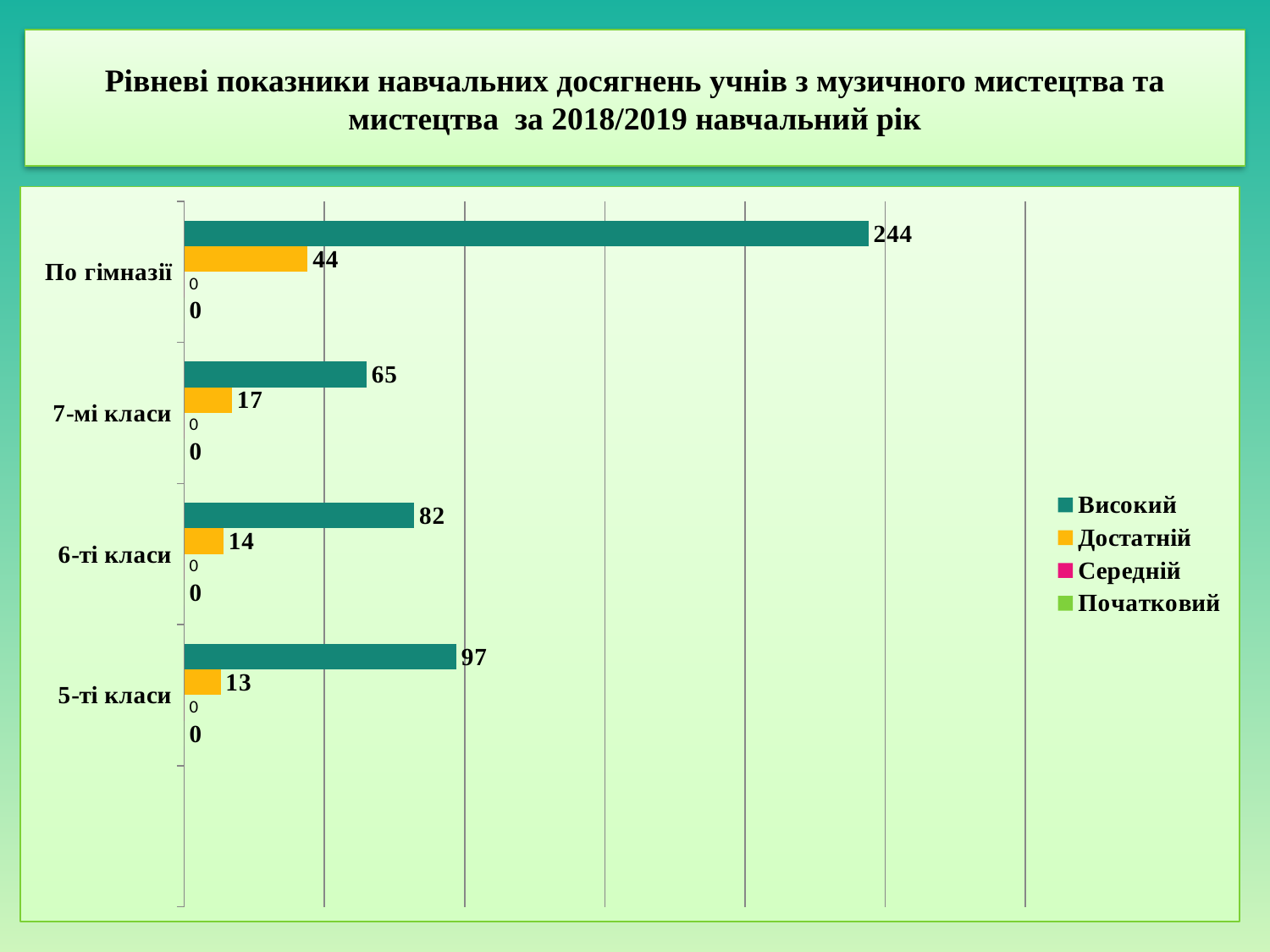
Which category has the lowest Достатній value? 5-ті класи What is the value of Середній for 5-ті класи? 0 Which is larger: the Достатній value for 7-мі класи or for 6-ті класи? 7-мі класи What is the value of Високий for По гімназії? 244 What is the difference between the Високий values for 6-ті класи and 7-мі класи? 17 What kind of chart is shown on the slide? bar chart Among the class groups 5-ті, 6-ті and 7-мі класи, which has the highest Високий value? 5-ті класи What is the value of Високий for 5-ті класи? 97 What is the value of Достатній for 7-мі класи? 17 How many series does the legend list? 4 How many categories are shown on the chart? 4 What is the value of Достатній for 6-ті класи? 14